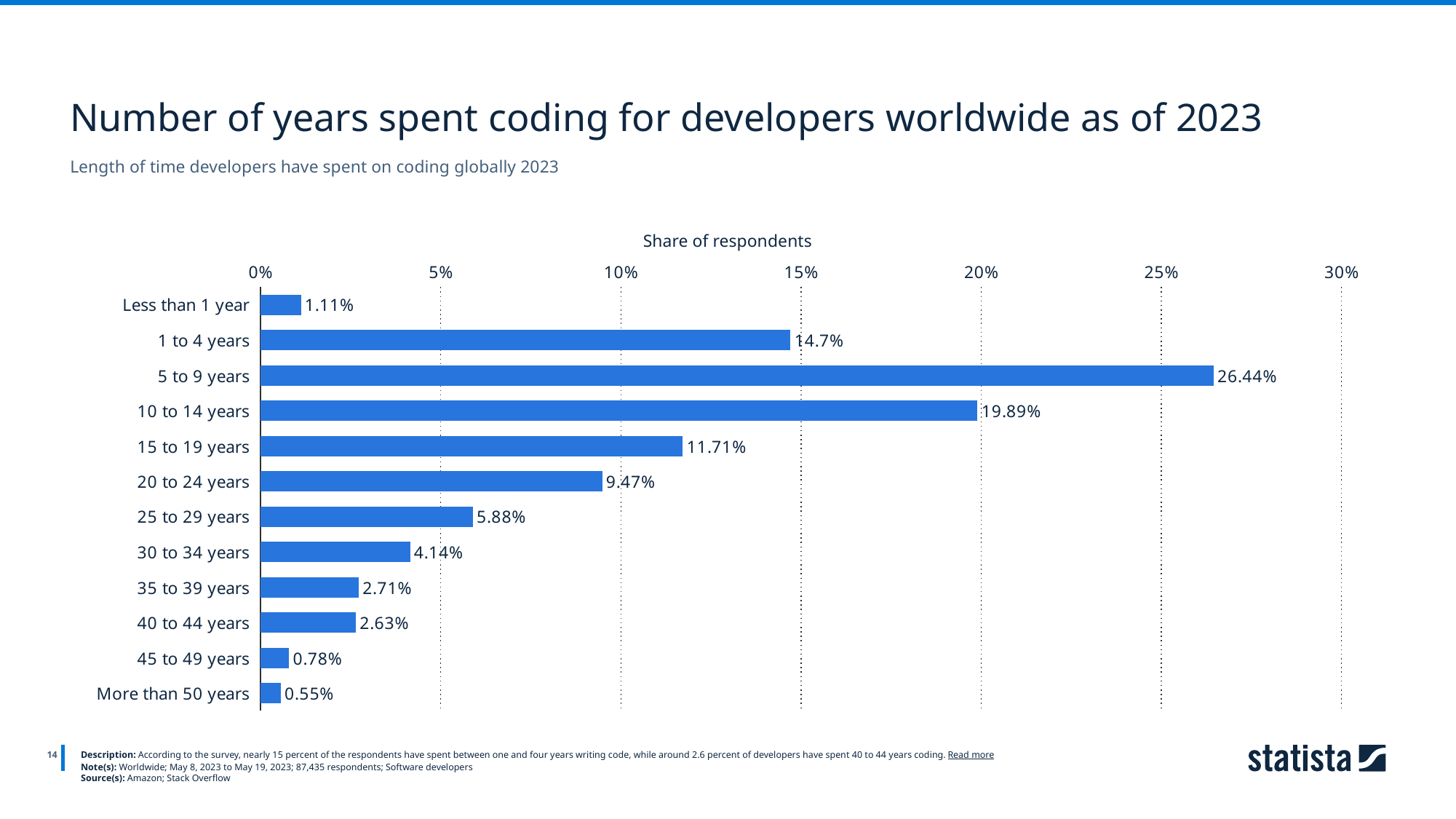
Is the value for 10 to 14 years greater or less than 20%? less How many categories are shown in the chart? 12 Which category has the lowest share of respondents? More than 50 years What kind of chart is shown on the slide? Bar chart What is the label of the horizontal axis? Share of respondents What is the difference between the shares for 35 to 39 years and 40 to 44 years? 0.08% What is the value for the 'More than 50 years' category? 0.55% What share of respondents have spent 5 to 9 years coding? 26.44% Which is larger, the share for 15 to 19 years or the share for 20 to 24 years? 15 to 19 years Which category has the highest share of respondents? 5 to 9 years What is the difference between the shares for 5 to 9 years and 10 to 14 years? 6.55% What share of respondents have spent 1 to 4 years coding? 14.7%